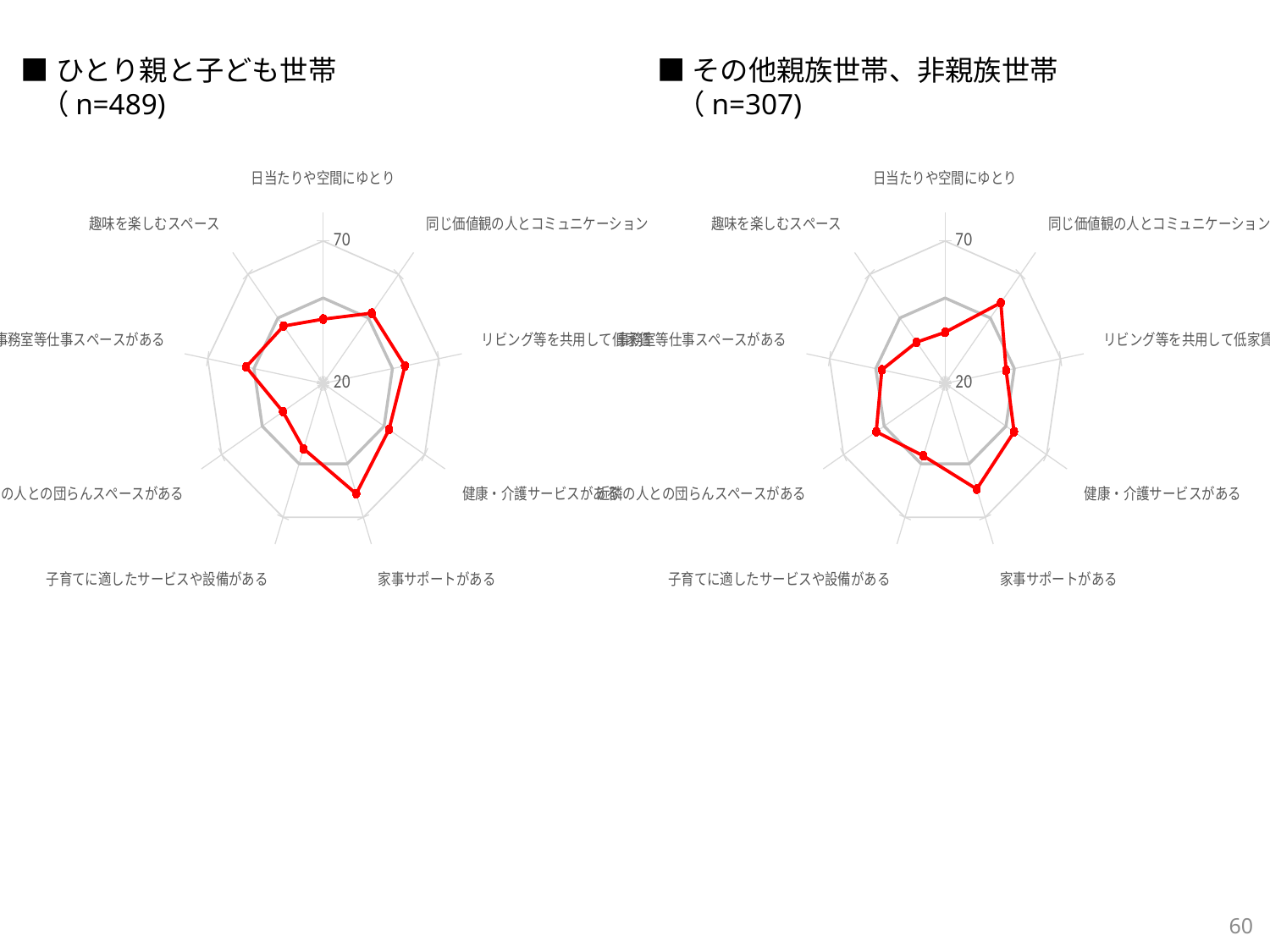
In the left chart (ひとり親と子ども世帯), which category has the highest value? 家事サポートがある How many categories (axes) does the left radar chart (ひとり親と子ども世帯) have? 9 What is the sample size (n) shown for the left chart, ひとり親と子ども世帯? n=489 In the left chart (ひとり親と子ども世帯), which is larger: 家事サポートがある or 日当たりや空間にゆとり? 家事サポートがある In the right chart (その他親族世帯、非親族世帯), is the value for 同じ価値観の人とコミュニケーション greater or less than 70? less What kind of chart is shown on the left side of the slide (ひとり親と子ども世帯)? Radar chart In the left chart (ひとり親と子ども世帯), is the value for 家事サポートがある greater or less than 70? less In the right chart (その他親族世帯、非親族世帯), which is larger: 同じ価値観の人とコミュニケーション or 日当たりや空間にゆとり? 同じ価値観の人とコミュニケーション In the right chart (その他親族世帯、非親族世帯), which category has the highest value? 家事サポートがある How many data series are plotted in the right chart (その他親族世帯、非親族世帯)? 2 What is the title of the right chart on the slide? その他親族世帯、非親族世帯 (n=307)